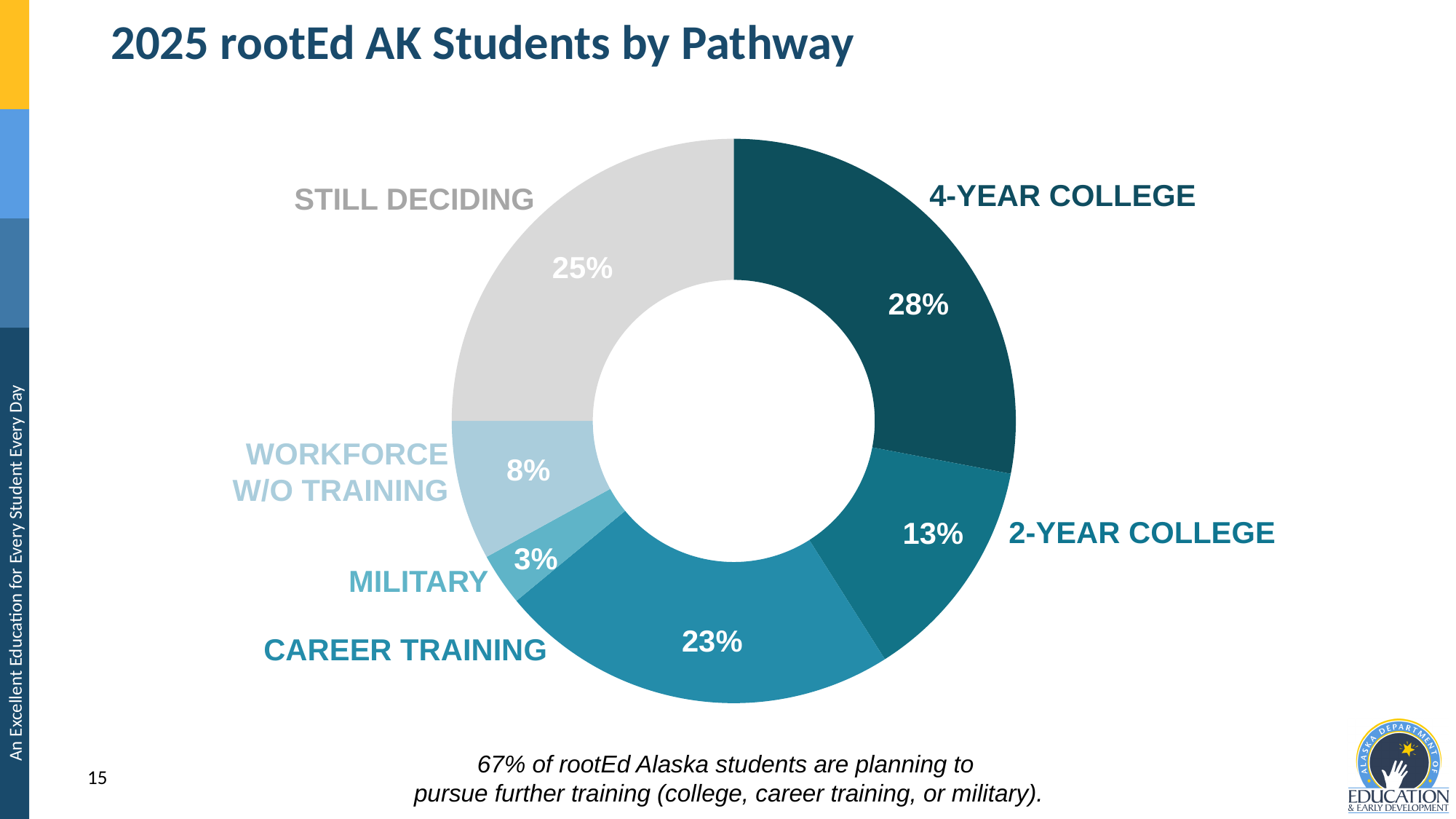
Which pathway has the smallest share of students? Military What percentage of students are Still Deciding? 25% What is the difference in percentage points between 4-Year College and 2-Year College? 15 Which pathway has the largest share of students? 4-Year College Which has a larger share, Workforce w/o Training or 2-Year College? 2-Year College How many pathway categories are shown in the chart? 6 What percentage of students chose Career Training? 23% What is the combined share of 4-Year College and 2-Year College? 41% What type of chart is shown on the slide? Doughnut (pie) chart What is the title of the slide? 2025 rootEd AK Students by Pathway What percentage of students chose the Military pathway? 3% What percentage of students chose the 4-Year College pathway? 28%